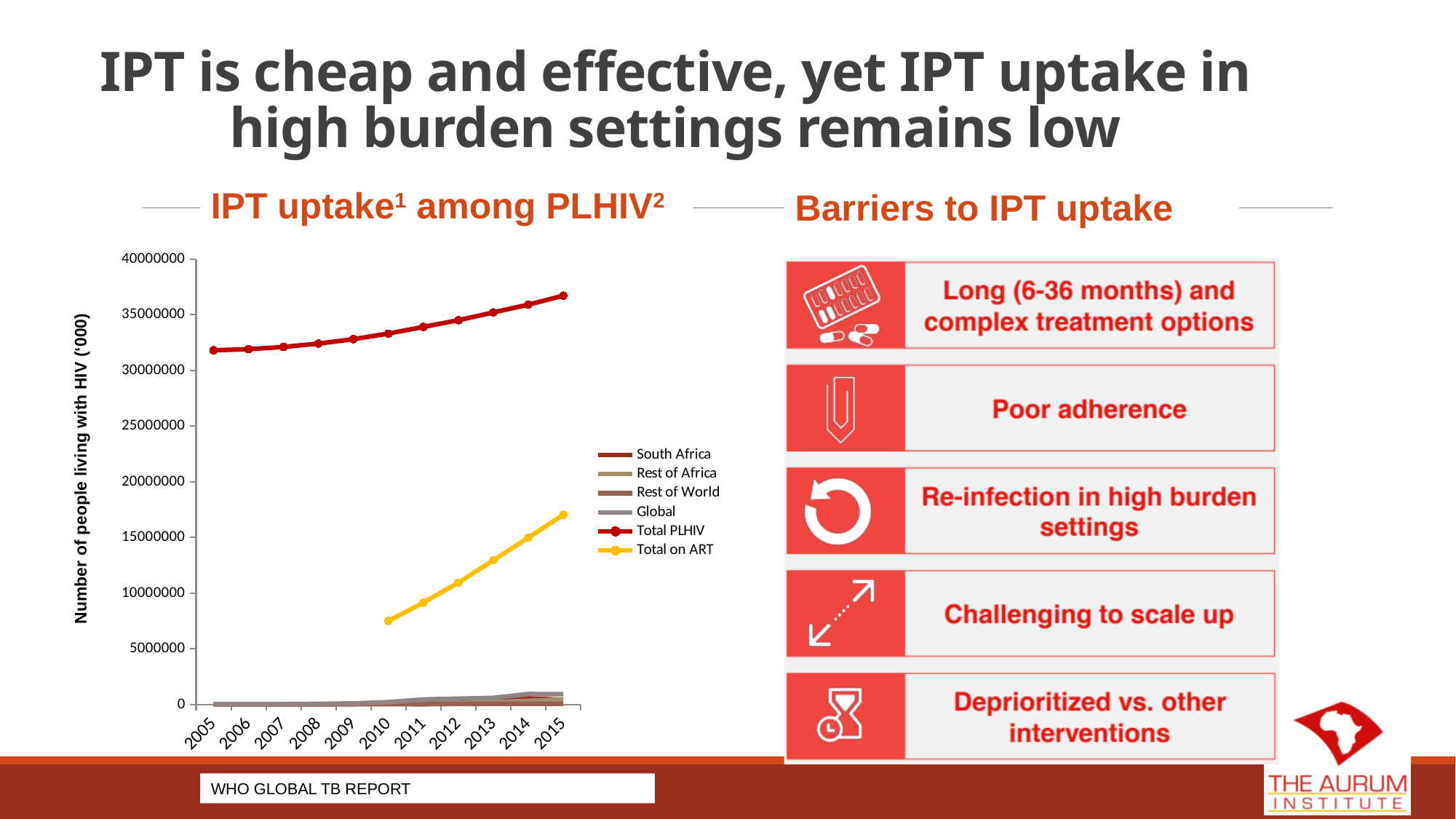
What is the label on the y axis of the line chart? Number of people living with HIV ('000) Does the Total on ART line rise or fall from 2010 to 2015? rise Is the value for Total on ART in 2015 greater or less than 15000000? greater What kind of chart is shown under the heading 'IPT uptake among PLHIV'? line chart Does the Total PLHIV line rise or fall from 2005 to 2015? rise How many series does the legend of the line chart list? 6 Is the value for Total PLHIV in 2005 greater or less than 30000000? greater Is the value for Total PLHIV in 2015 greater or less than 35000000? greater Which is larger in 2015, Total PLHIV or Total on ART? Total PLHIV In which year does the Total on ART line first appear on the chart? 2010 How many years are shown along the x axis of the line chart? 11